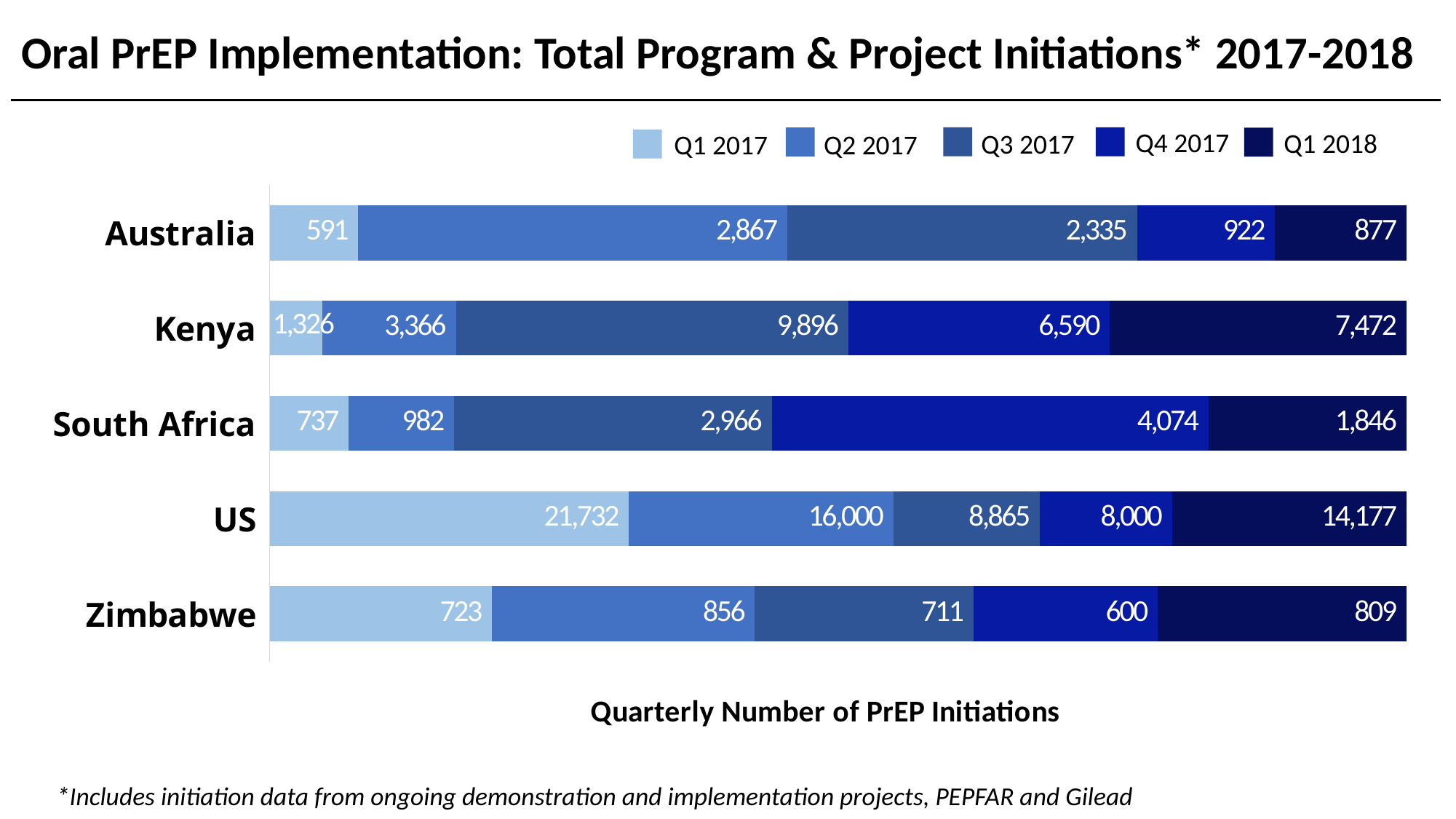
How many series does the legend list? 5 Which country has the lowest value in Q2 2017? Zimbabwe What is the x-axis title of the chart? Quarterly Number of PrEP Initiations Which is larger: South Africa's Q4 2017 value or Australia's Q2 2017 value? South Africa's Q4 2017 value Which country has the highest value in Q1 2018? US What is the value for the US in Q1 2017? 21,732 What is the value for Zimbabwe in Q4 2017? 600 What is the total of all five quarters for Zimbabwe? 3,699 What is the difference between Kenya's Q1 2018 value and its Q4 2017 value? 882 How many countries are shown on the chart? 5 What kind of chart is shown on the slide? Stacked bar chart What is the value for Kenya in Q3 2017? 9,896